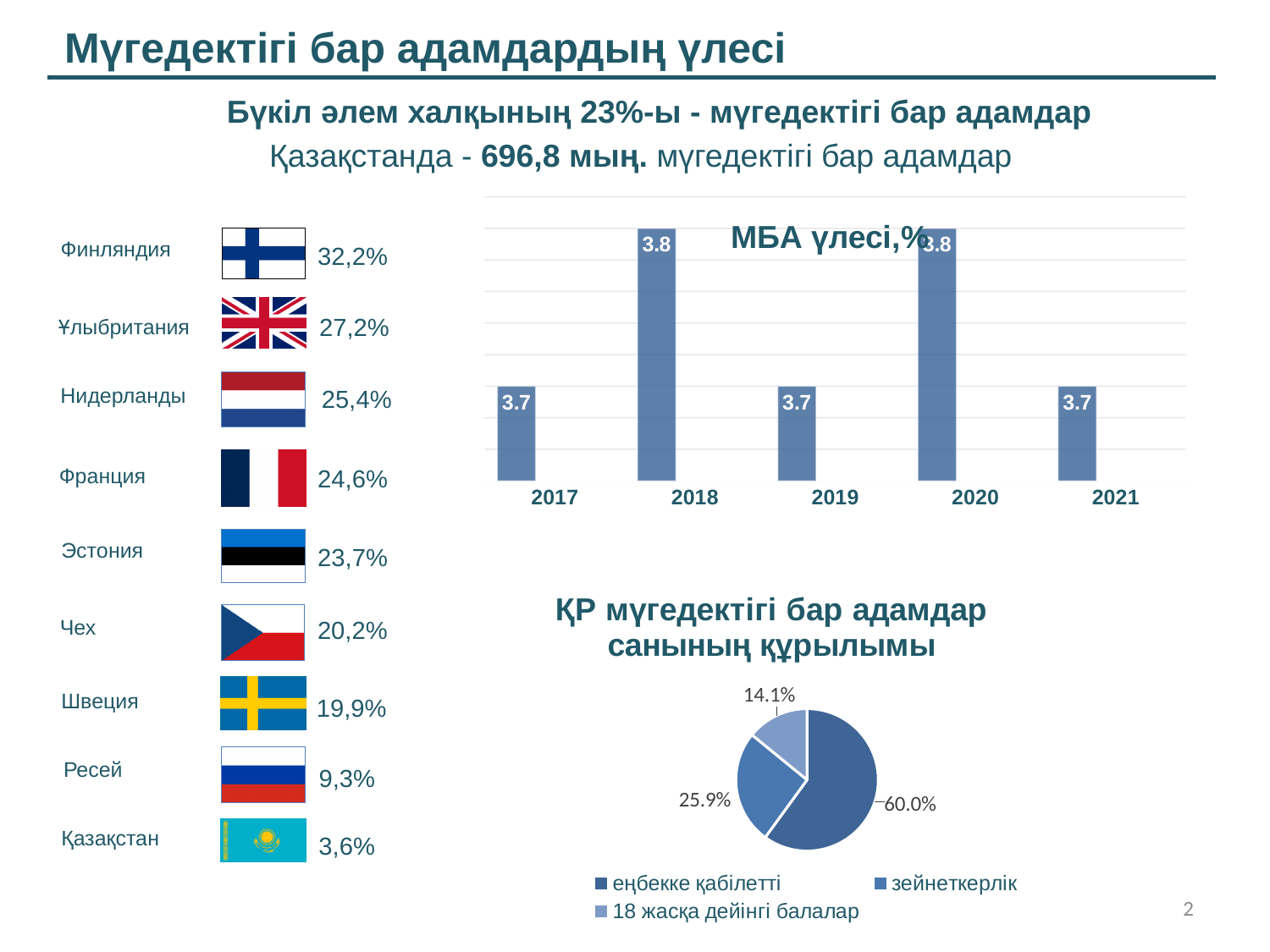
In the bar chart titled 'МБА үлесі,%', how many years are shown on the x axis? 5 In the pie chart titled 'ҚР мүгедектігі бар адамдар санының құрылымы', what share does 'зейнеткерлік' have? 25.9% In the bar chart titled 'МБА үлесі,%', which year has the larger value, 2019 or 2020? 2020 What kind of chart is the 'МБА үлесі,%' chart? bar chart In the bar chart titled 'МБА үлесі,%', what is the difference between the values for 2018 and 2017? 0.1 What kind of chart is the 'ҚР мүгедектігі бар адамдар санының құрылымы' chart? pie chart In the pie chart titled 'ҚР мүгедектігі бар адамдар санының құрылымы', how many entries does the legend list? 3 In the pie chart titled 'ҚР мүгедектігі бар адамдар санының құрылымы', what share does 'еңбекке қабілетті' have? 60.0% In the bar chart titled 'МБА үлесі,%', what is the value for 2021? 3.7 In the bar chart titled 'МБА үлесі,%', what is the value for 2018? 3.8 In the pie chart titled 'ҚР мүгедектігі бар адамдар санының құрылымы', which category has the smallest slice? 18 жасқа дейінгі балалар In the pie chart titled 'ҚР мүгедектігі бар адамдар санының құрылымы', how many slices are there? 3